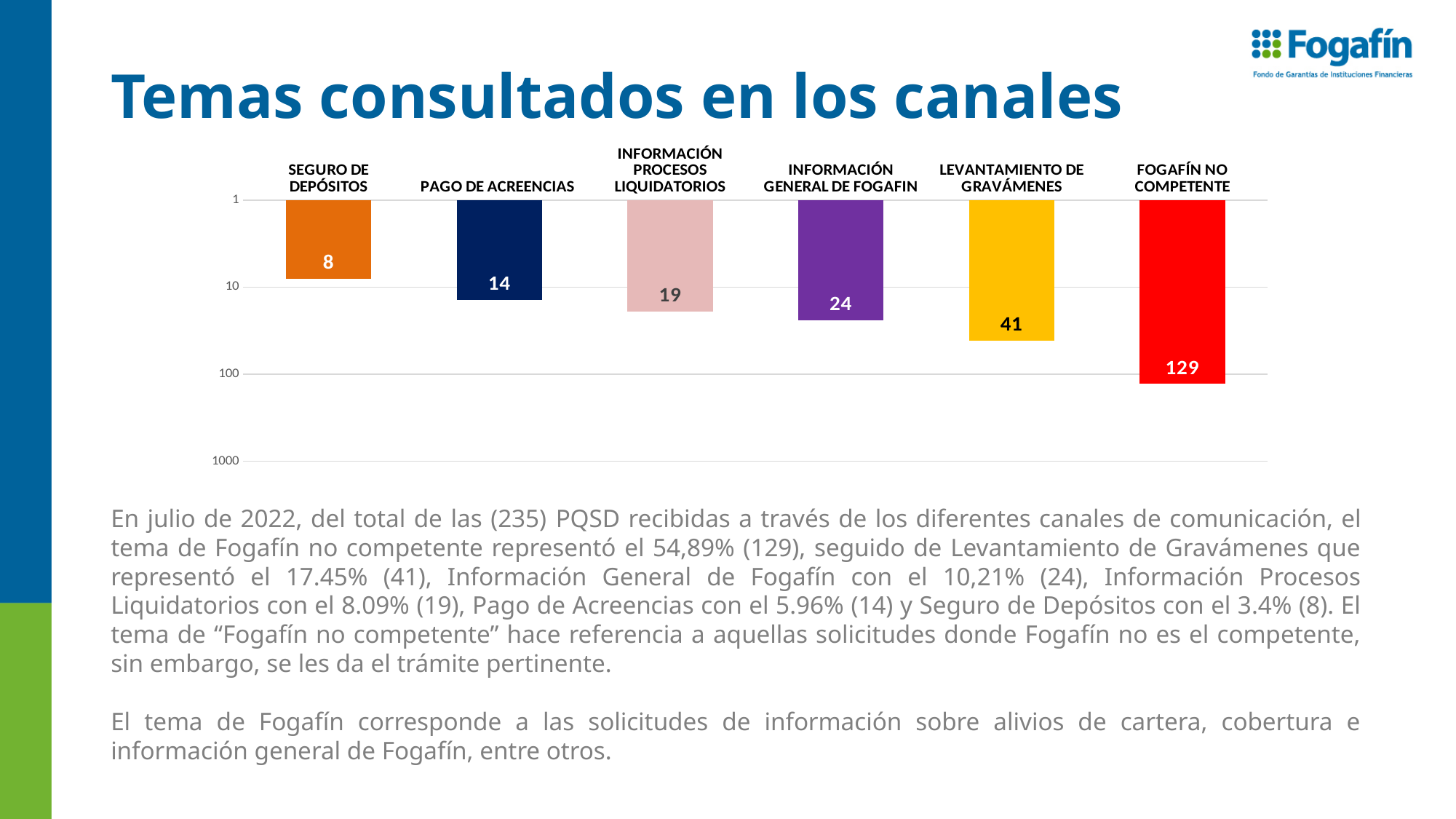
What colour is the bar for FOGAFÍN NO COMPETENTE? red What is the value for LEVANTAMIENTO DE GRAVÁMENES? 41 How many categories are shown in the chart? 6 What is the value for PAGO DE ACREENCIAS? 14 Which category has the highest value? FOGAFÍN NO COMPETENTE What is the difference between the values for FOGAFÍN NO COMPETENTE and LEVANTAMIENTO DE GRAVÁMENES? 88 Do the values rise or fall from left to right across the categories? rise Which is larger, the value for INFORMACIÓN GENERAL DE FOGAFIN or the value for INFORMACIÓN PROCESOS LIQUIDATORIOS? INFORMACIÓN GENERAL DE FOGAFIN Which category has the lowest value? SEGURO DE DEPÓSITOS What kind of chart is shown on the slide? bar chart What is the value for INFORMACIÓN PROCESOS LIQUIDATORIOS? 19 What is the value for SEGURO DE DEPÓSITOS? 8